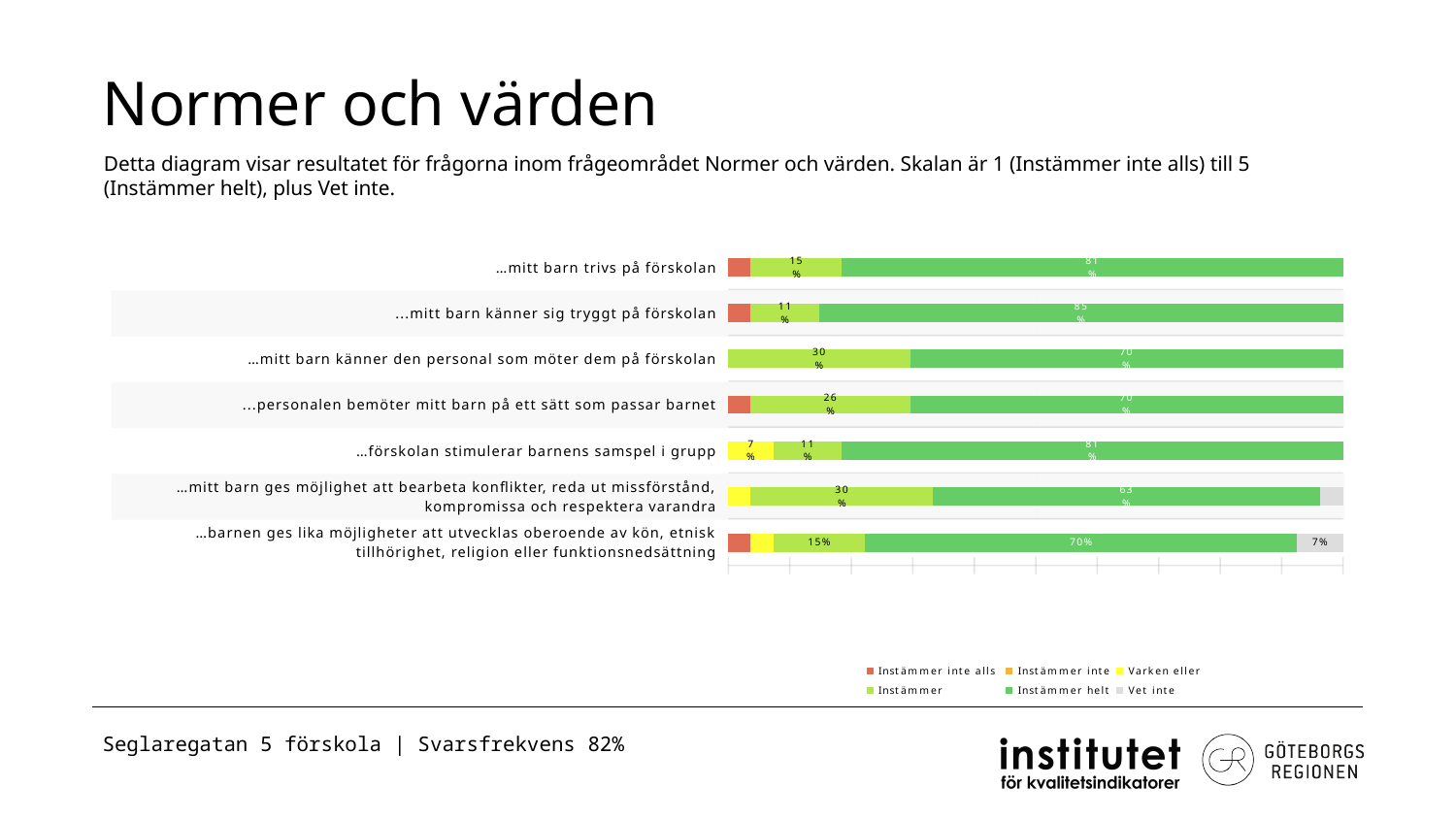
What kind of chart is shown on the slide? Stacked bar chart Which statement has the highest 'Instämmer helt' share? …mitt barn känner sig tryggt på förskolan What is the 'Vet inte' value for '…barnen ges lika möjligheter att utvecklas oberoende av kön, etnisk tillhörighet, religion eller funktionsnedsättning'? 7% How many series does the legend list? 6 What is the title of the slide containing the chart? Normer och värden Which statement has the lowest 'Instämmer helt' share? …mitt barn ges möjlighet att bearbeta konflikter, reda ut missförstånd, kompromissa och respektera varandra Which has the larger 'Instämmer' share: '…personalen bemöter mitt barn på ett sätt som passar barnet' or '…mitt barn trivs på förskolan'? …personalen bemöter mitt barn på ett sätt som passar barnet How many statements (categories) are plotted in the chart? 7 What is the difference in 'Instämmer helt' between '…mitt barn känner sig tryggt på förskolan' and '…mitt barn trivs på förskolan'? 4 percentage points What is the 'Instämmer helt' value for '…mitt barn känner sig tryggt på förskolan'? 85% What is the 'Instämmer' value for '…mitt barn känner den personal som möter dem på förskolan'? 30% What is the 'Varken eller' value for '…förskolan stimulerar barnens samspel i grupp'? 7%